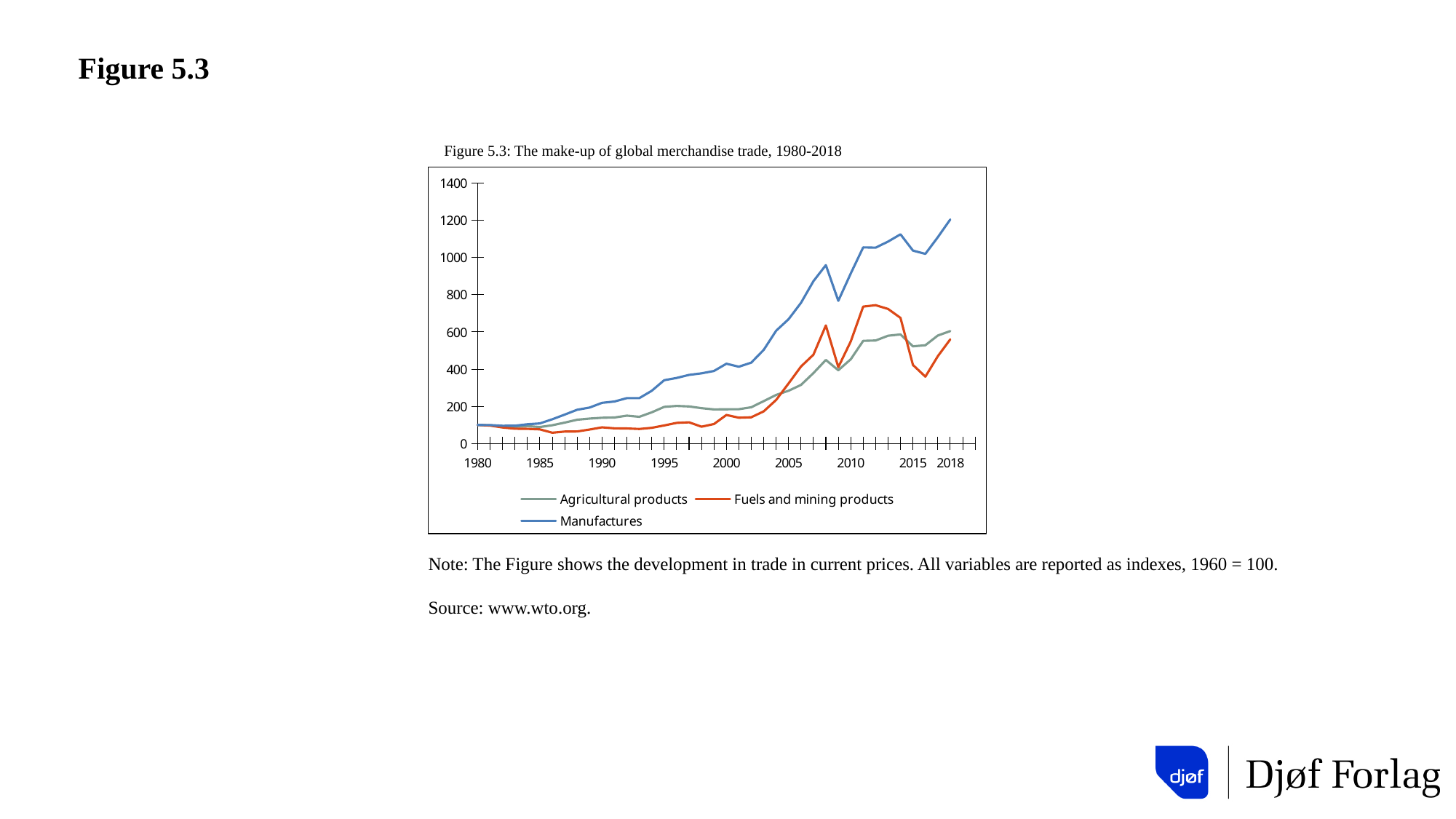
Does the Manufactures series overall rise or fall from 1980 to 2018? rise What kind of chart is shown on the slide? line chart Which series has the lowest value in 2016? Fuels and mining products What is the title of the chart? Figure 5.3: The make-up of global merchandise trade, 1980-2018 Is the value for Agricultural products in 2005 greater or less than 200? greater Which series is drawn in blue? Manufactures Is the value for Fuels and mining products in 2016 greater or less than 400? less How many series does the legend list? 3 Is the value for Fuels and mining products in 2012 greater or less than 600? greater In 2012, which is larger: Fuels and mining products or Agricultural products? Fuels and mining products Which series has the highest value in 2018? Manufactures